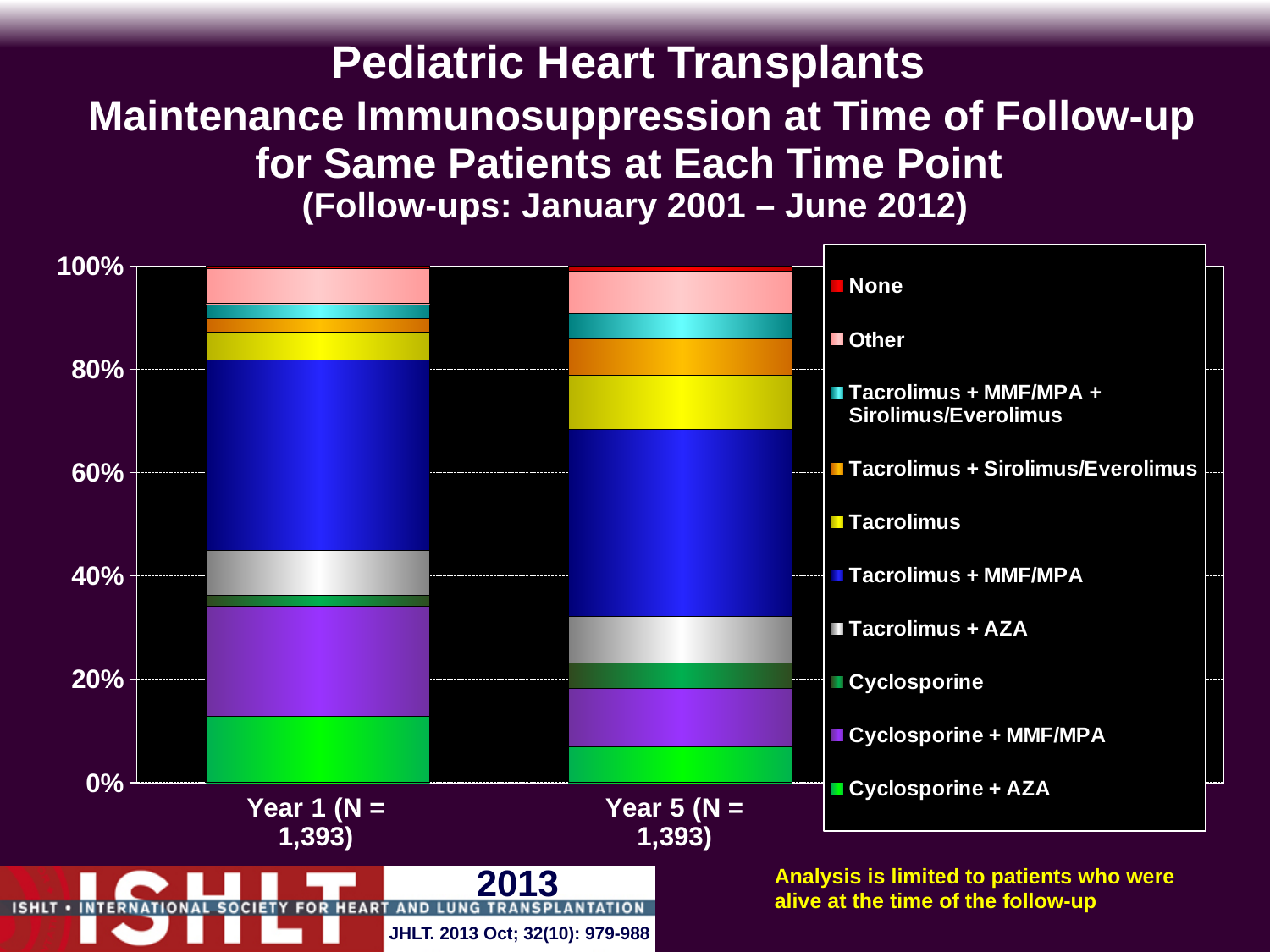
Is the Cyclosporine + AZA share in the Year 1 (N = 1,393) bar greater or less than 20%? less Which bar has the larger Tacrolimus segment, Year 1 (N = 1,393) or Year 5 (N = 1,393)? Year 5 (N = 1,393) How many bars (time points) are plotted on the chart? 2 What is the N shown for the Year 5 bar? 1,393 Which bar has the larger Cyclosporine + MMF/MPA segment, Year 1 (N = 1,393) or Year 5 (N = 1,393)? Year 1 (N = 1,393) Is the Cyclosporine + AZA share in the Year 5 (N = 1,393) bar greater or less than 20%? less Which bar has the larger Cyclosporine + AZA segment, Year 1 (N = 1,393) or Year 5 (N = 1,393)? Year 1 (N = 1,393) What is the total height of the Year 1 (N = 1,393) stacked bar? 100% Which legend entry is shown in red? None Does the Cyclosporine + AZA share rise or fall from Year 1 to Year 5? Fall How many series does the legend list? 10 What kind of chart is shown on the slide? Stacked bar chart